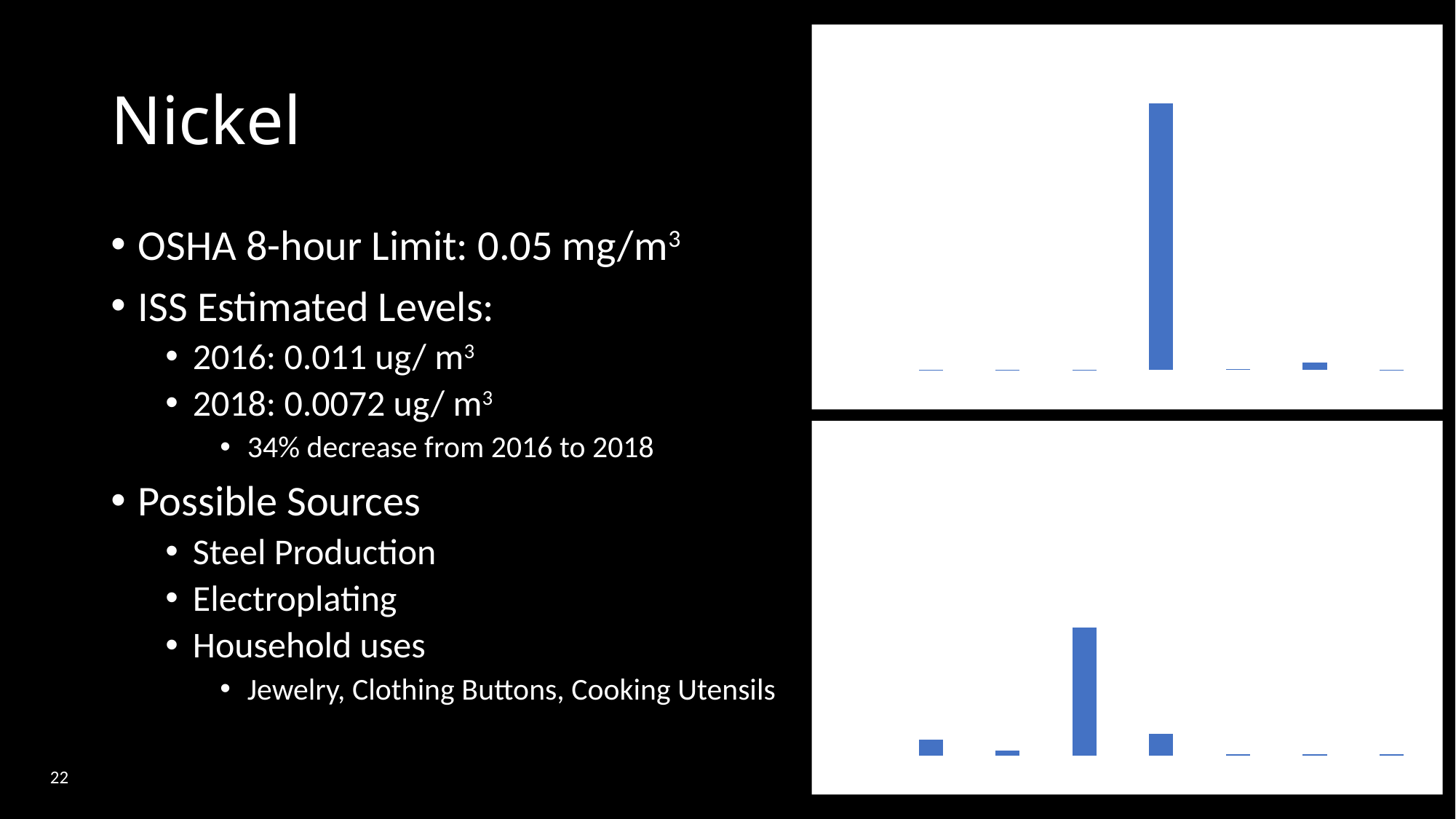
In the top chart, which bar (counting from the left) is the tallest? the fourth bar What colour are the bars in both charts? blue In the bottom chart, how many bars are plotted? 7 What kind of chart is the top chart on the right side of the slide? bar chart Do the charts on the slide display a legend? No In the top chart, which is taller: the fourth bar from the left or the sixth bar from the left? the fourth bar What kind of chart is the bottom chart on the right side of the slide? bar chart In the top chart, how many bars are plotted? 7 In the bottom chart, which bar (counting from the left) is the tallest? the third bar In the bottom chart, which is taller: the third bar from the left or the fourth bar from the left? the third bar In the bottom chart, which is taller: the first bar from the left or the second bar from the left? the first bar